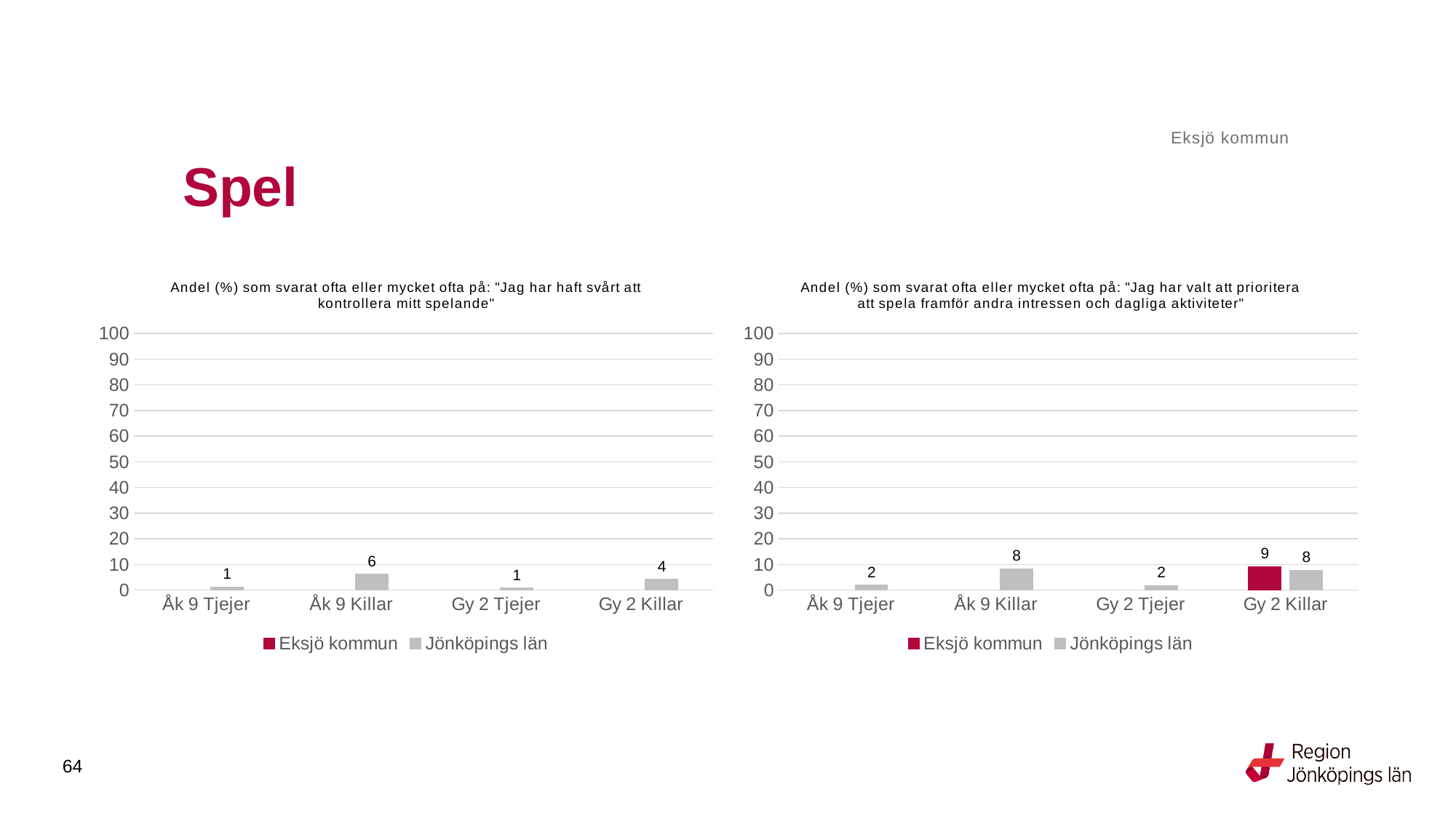
In the right chart ("Jag har valt att prioritera att spela framför andra intressen..."), what is the difference between the Jönköpings län values for Åk 9 Killar and Gy 2 Tjejer? 6 In the left chart ("Jag har haft svårt att kontrollera mitt spelande"), what is the value for Jönköpings län for Åk 9 Killar? 6 In the left chart ("Jag har haft svårt att kontrollera mitt spelande"), what is the difference between the Jönköpings län values for Åk 9 Killar and Gy 2 Killar? 2 In the right chart ("Jag har valt att prioritera att spela framför andra intressen..."), what is the value for Jönköpings län for Åk 9 Tjejer? 2 In the right chart ("Jag har valt att prioritera att spela framför andra intressen..."), is the value for Eksjö kommun for Gy 2 Killar greater or less than 20? less In the right chart ("Jag har valt att prioritera att spela framför andra intressen..."), what is the value for Eksjö kommun for Gy 2 Killar? 9 How many categories are shown on the x axis of the left chart? 4 How many series does the legend of the right chart list? 2 In the right chart ("Jag har valt att prioritera att spela framför andra intressen..."), which is larger for Gy 2 Killar: Eksjö kommun or Jönköpings län? Eksjö kommun What kind of chart is the left chart? Bar chart In the left chart ("Jag har haft svårt att kontrollera mitt spelande"), which category has the highest value for Jönköpings län? Åk 9 Killar In the left chart ("Jag har haft svårt att kontrollera mitt spelande"), what is the value for Jönköpings län for Gy 2 Killar? 4